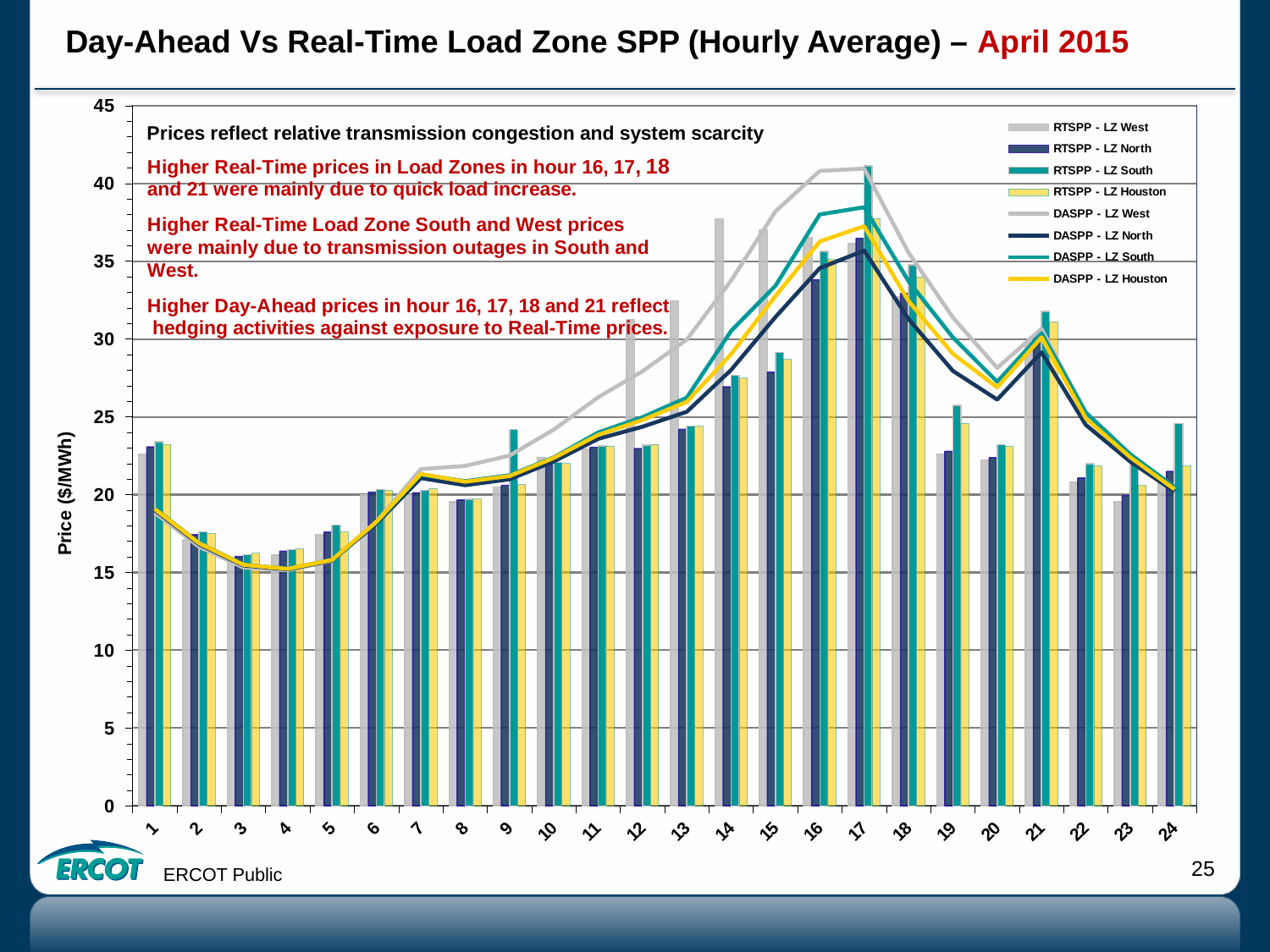
Do the DASPP - LZ North values rise or fall from hour 4 to hour 17? rise How many series does the legend list? 8 What is the label on the y axis? Price ($/MWh) What kind of chart is shown on the slide? A combination bar and line chart Is the RTSPP - LZ North value in hour 19 greater or less than 25? less How many hours are shown along the x axis? 24 Is the RTSPP - LZ Houston value in hour 4 greater or less than 20? less In hour 14, which is larger: RTSPP - LZ West or RTSPP - LZ Houston? RTSPP - LZ West In which hour is the RTSPP - LZ West bar highest? 14 In hour 17, which is larger: RTSPP - LZ West or RTSPP - LZ North? RTSPP - LZ North Is the RTSPP - LZ West value in hour 14 greater or less than 35? greater